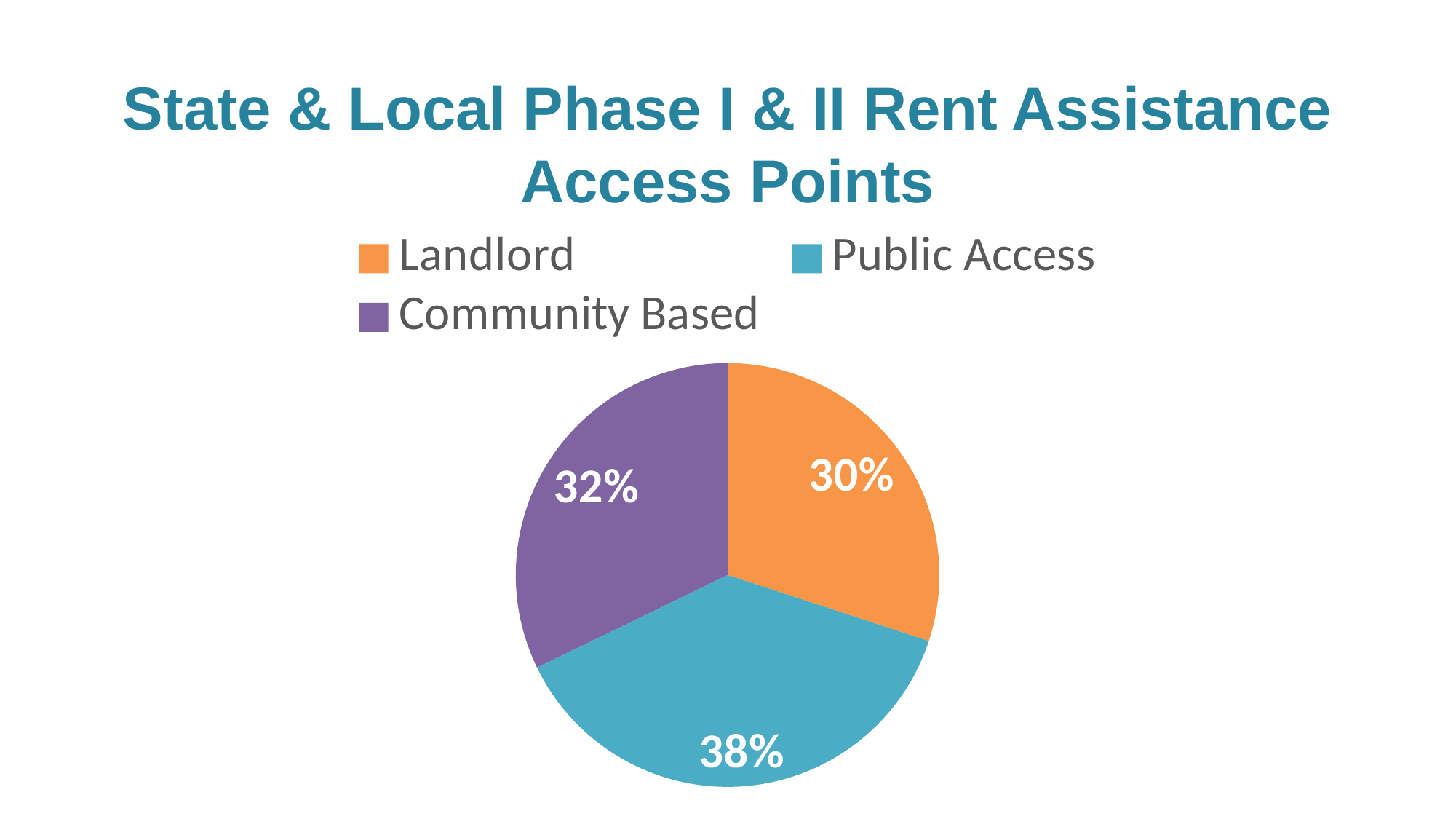
What percentage of access points is Landlord? 30% Which category has the largest share of the pie? Public Access What type of chart is shown on the slide? Pie chart What percentage of access points is Public Access? 38% How many categories does the pie chart show? 3 What percentage of access points is Community Based? 32% What colour represents Community Based in the chart? Purple Which is larger, the Community Based share or the Public Access share? Public Access Which category has the smallest share of the pie? Landlord What is the difference in percentage points between Public Access and Landlord? 8 What is the difference in percentage points between Community Based and Landlord? 2 What is the title of the chart? State & Local Phase I & II Rent Assistance Access Points